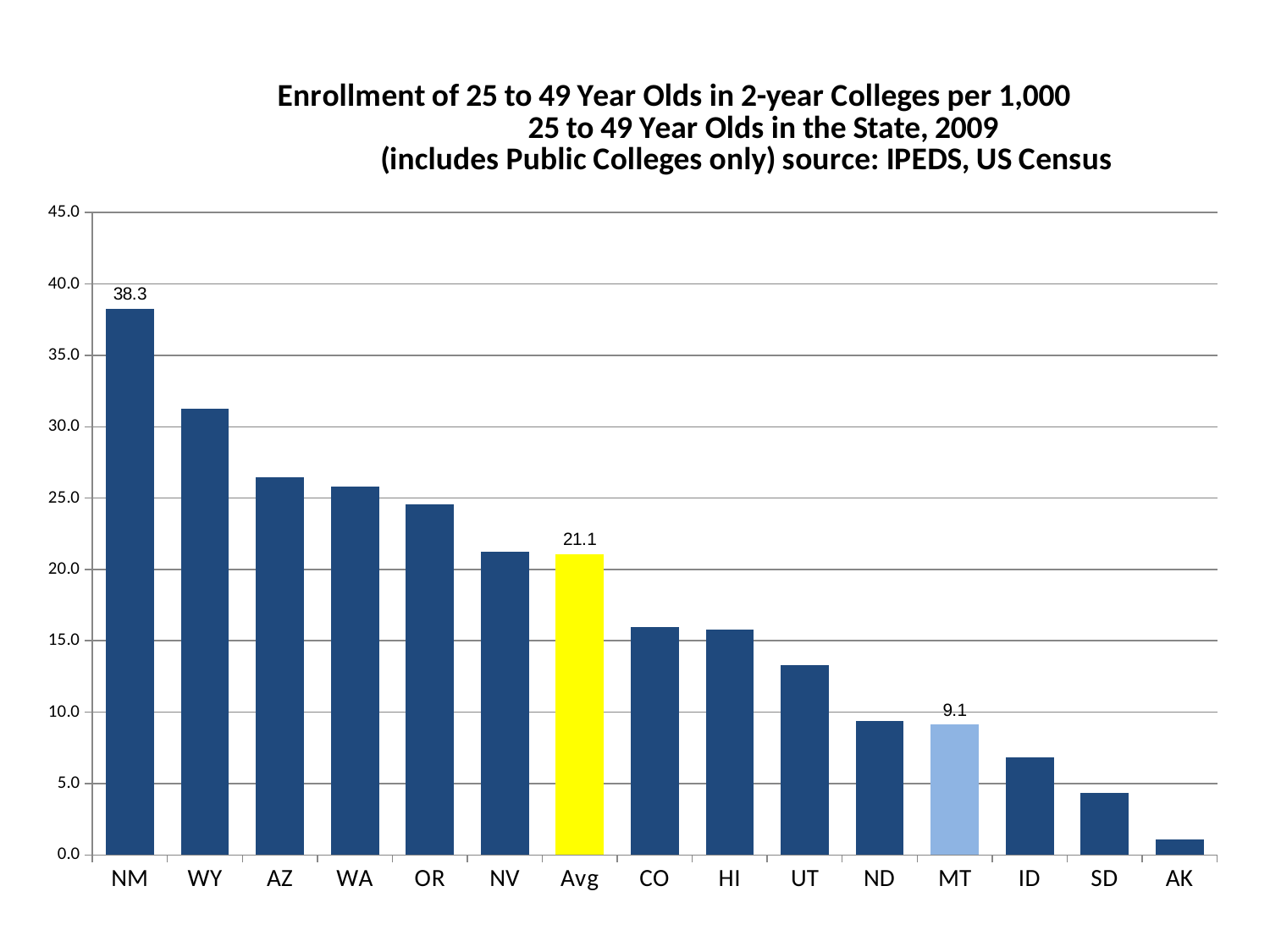
Which category has the highest value? NM Is the value for ID greater or less than 10.0? less Which is larger, the value for WY or the value for AZ? WY What is the value for Avg? 21.1 Which category has the lowest value? AK What is the value for NM? 38.3 What kind of chart is shown on the slide? bar chart What is the difference between the values for NM and MT? 29.2 Is the value for UT greater or less than 10.0? greater What is the value for MT? 9.1 How many categories are shown on the x axis? 15 What is the difference between the values for NM and Avg? 17.2